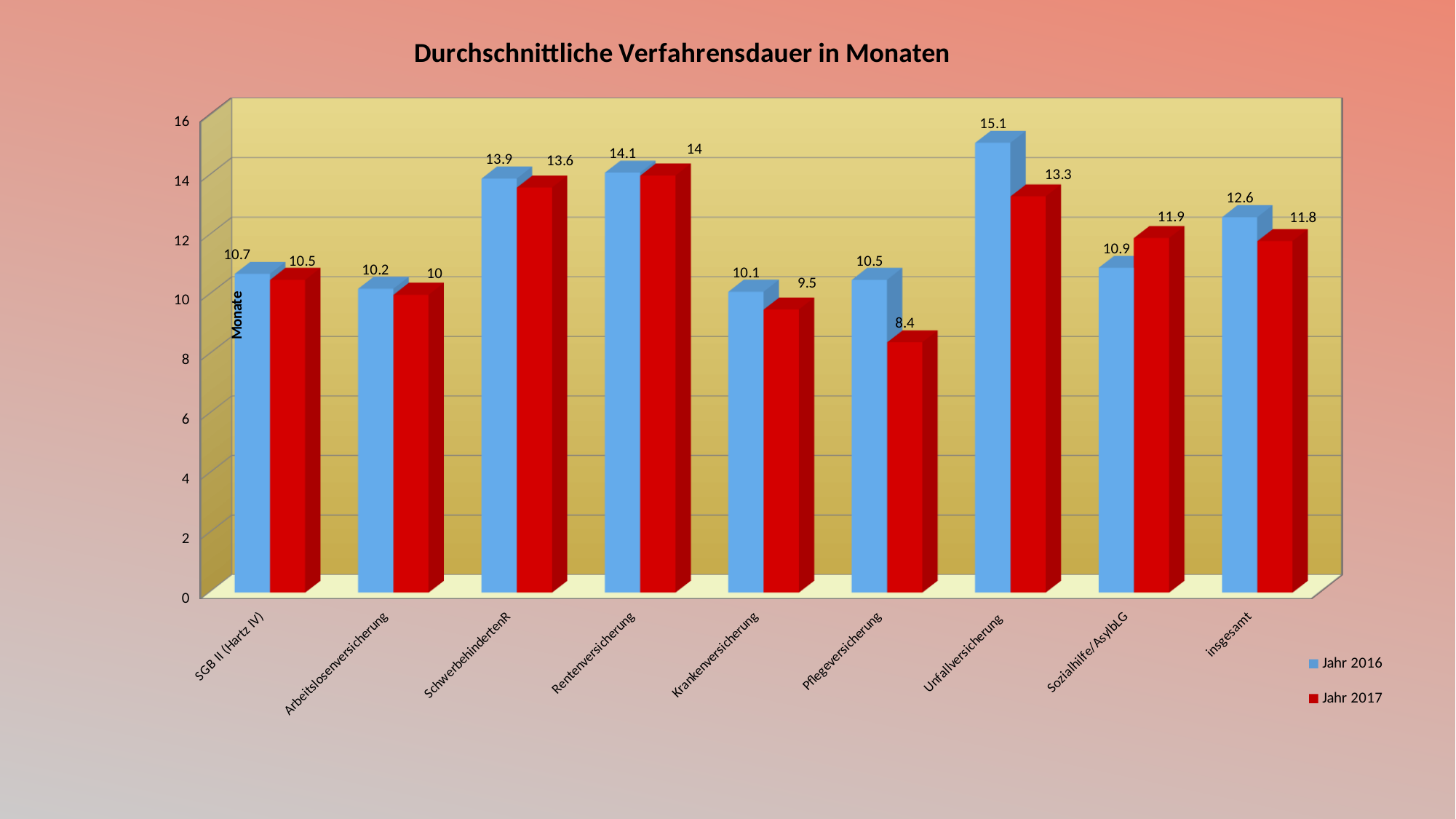
What is the difference between the Jahr 2016 and Jahr 2017 values for Unfallversicherung? 1.8 What is the value for Unfallversicherung in Jahr 2016? 15.1 Which category has the highest value in Jahr 2016? Unfallversicherung Which is larger for Sozialhilfe/AsylbLG: the Jahr 2016 value or the Jahr 2017 value? Jahr 2017 What is the title of the chart? Durchschnittliche Verfahrensdauer in Monaten What is the value for insgesamt in Jahr 2017? 11.8 What kind of chart is shown on the slide? Bar chart How many categories are shown on the x axis? 9 Which colour represents Jahr 2017 in the chart? Red What is the value for Pflegeversicherung in Jahr 2017? 8.4 Which category has the lowest value in Jahr 2017? Pflegeversicherung How many series does the legend list? 2